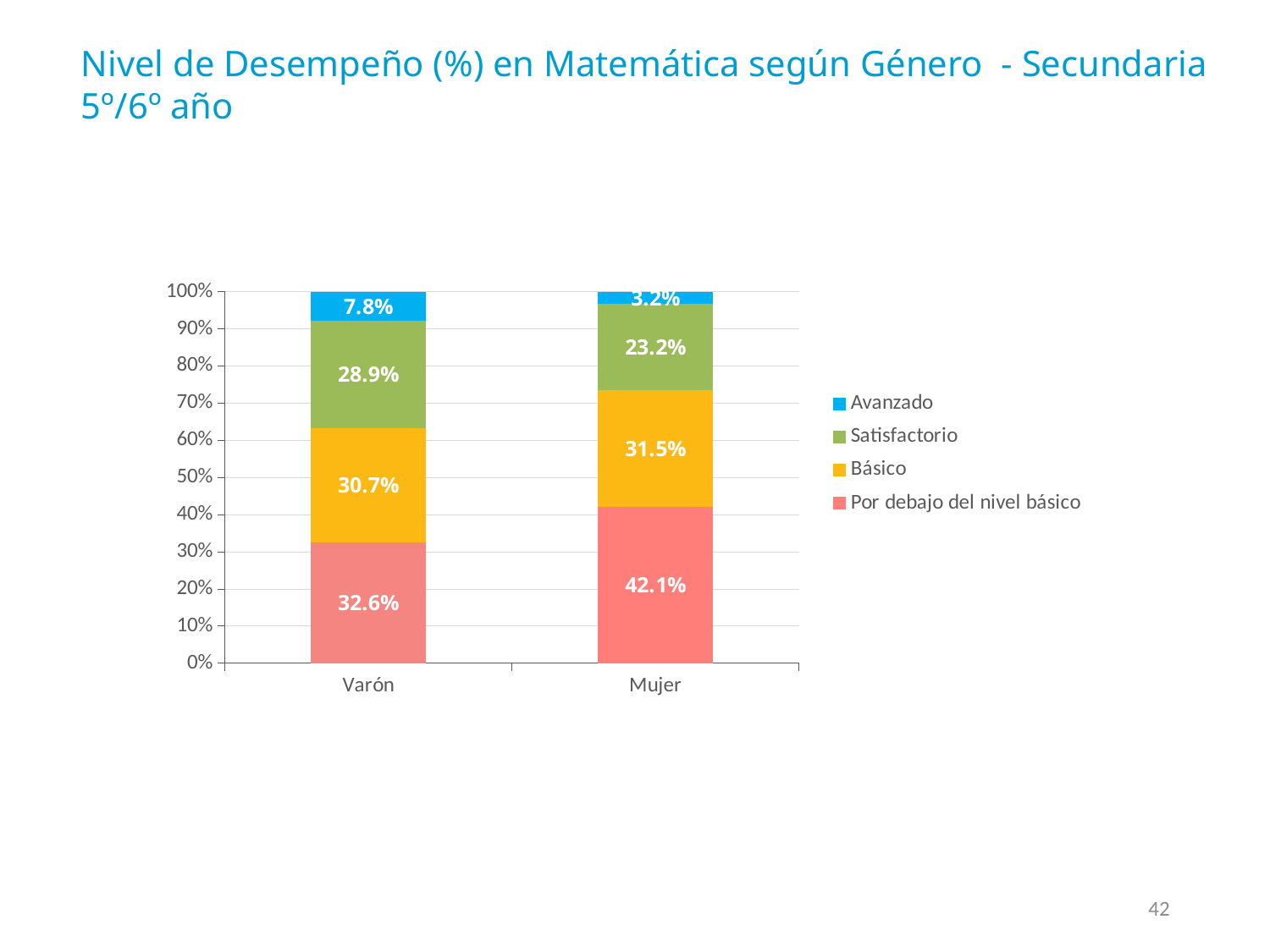
What is the Por debajo del nivel básico value for Mujer? 42.1% What is the Avanzado value for Varón? 7.8% What is the difference between the Satisfactorio values for Varón and Mujer? 5.7 percentage points How many categories are shown on the x axis? 2 What is the Básico value for Mujer? 31.5% Which series is shown in blue in the legend? Avanzado Which category has the higher Avanzado value, Varón or Mujer? Varón Which category has the higher Por debajo del nivel básico value, Varón or Mujer? Mujer What is the difference between the Por debajo del nivel básico values for Mujer and Varón? 9.5 percentage points What is the Satisfactorio value for Varón? 28.9% What kind of chart is shown on the slide? Stacked bar chart How many series does the legend list? 4